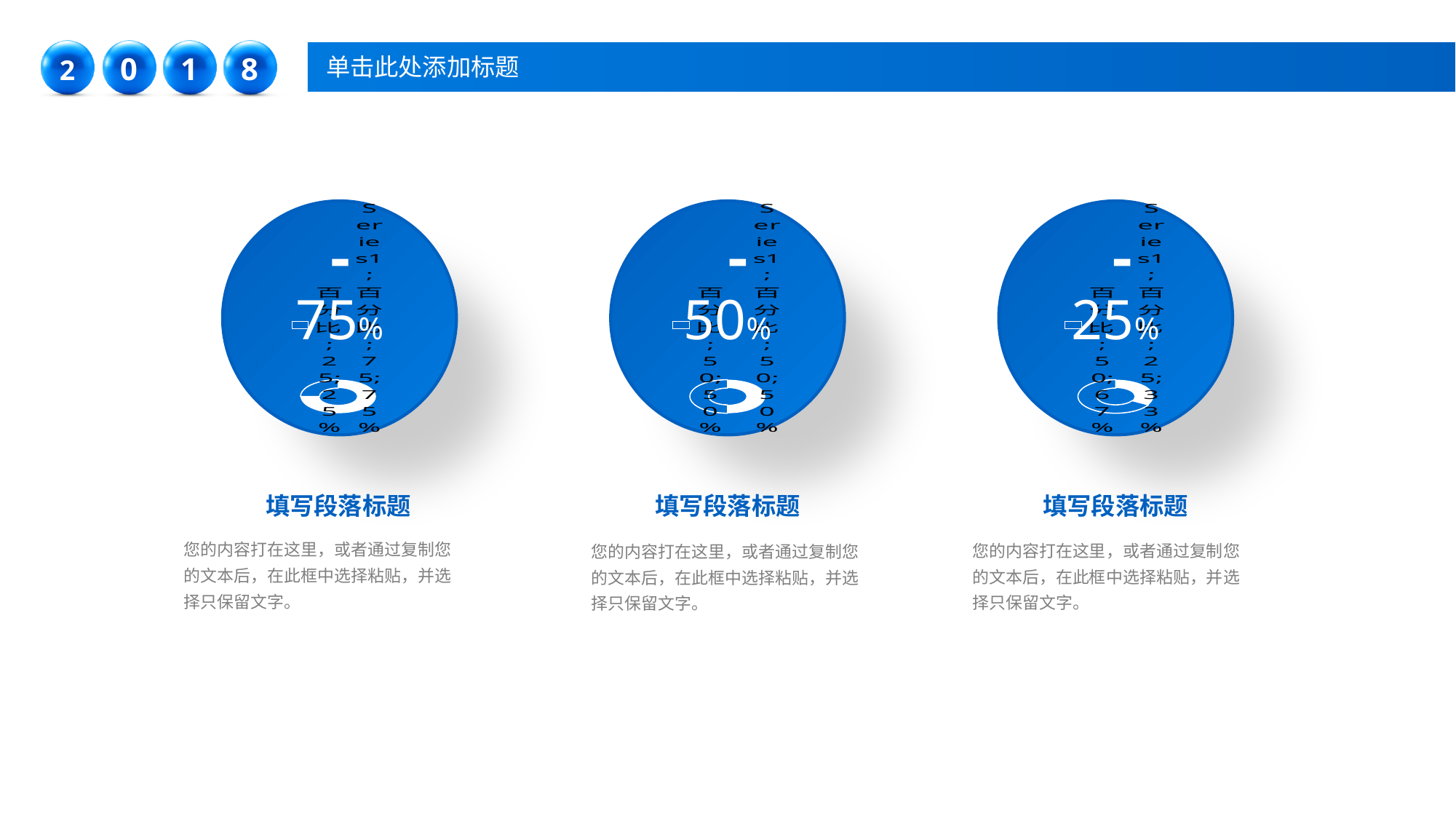
What series name appears in the legend text of each circle chart? Series1 Which circle chart shows the lowest percentage: left, middle or right? Right Which circle chart shows the highest percentage: left, middle or right? Left What percentage is displayed on the middle circle chart? 50% What percentage is displayed on the left circle chart? 75% Is the percentage on the middle circle chart larger or smaller than the percentage on the right circle chart? Larger What percentage is displayed on the right circle chart? 25% What is the difference between the percentage on the left circle chart and the percentage on the right circle chart? 50% How many doughnut charts are on the slide? 3 What colour are the circles that contain the doughnut charts? Blue What kind of chart is shown inside each of the three blue circles? Doughnut (pie) chart What is the difference between the percentage on the left circle chart and the percentage on the middle circle chart? 25%